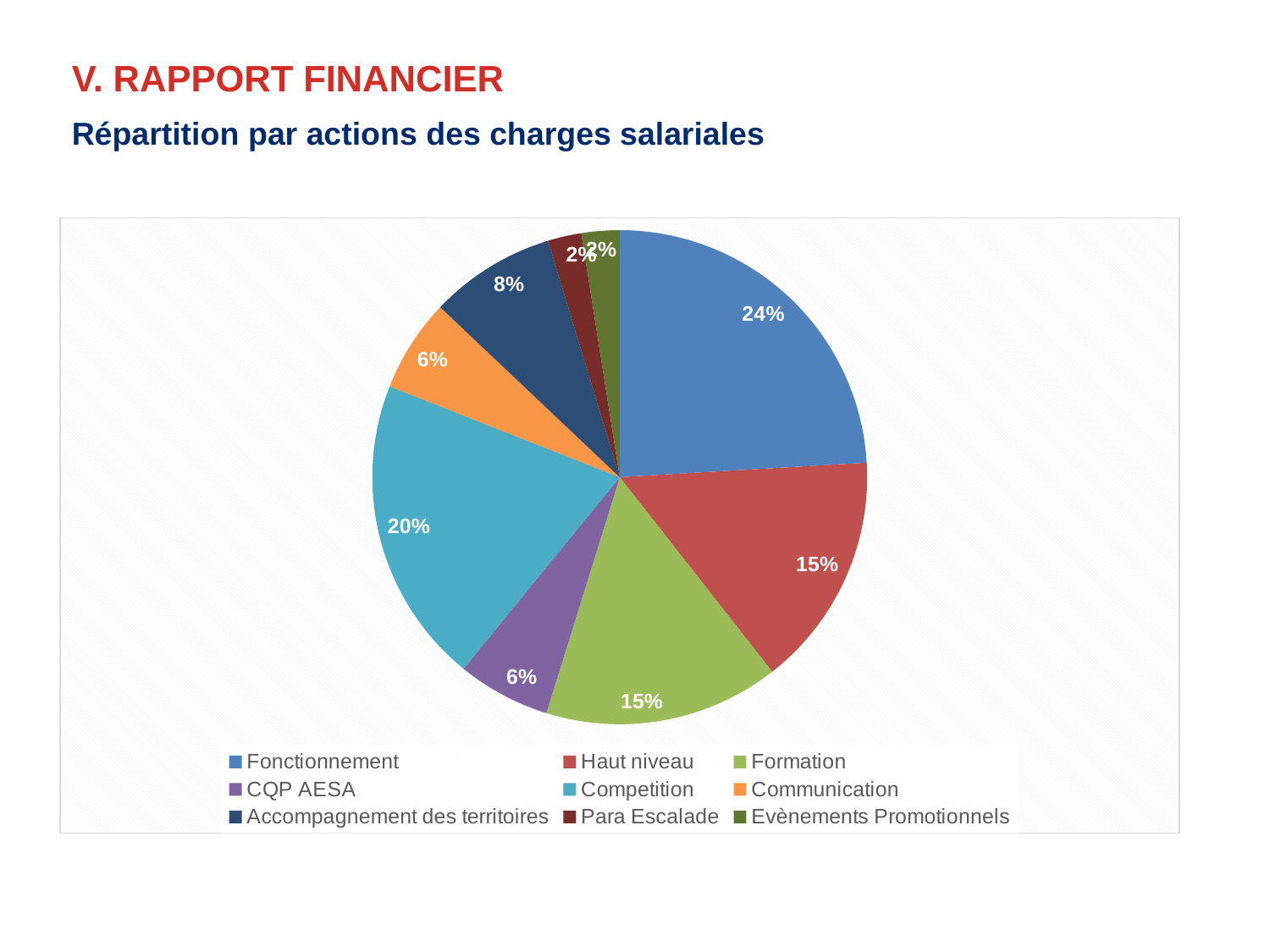
What is the value shown for Communication? 6% Which category is shown in orange in the legend? Communication What is the value shown for Accompagnement des territoires? 8% What is the subtitle describing the chart on the slide? Répartition par actions des charges salariales Which category has the largest share of the pie? Fonctionnement What share of the pie does Fonctionnement represent? 24% What is the value shown for Competition? 20% What is the difference in percentage points between Fonctionnement and Competition? 4 What is the value shown for Haut niveau? 15% What kind of chart is shown on the slide? pie chart How many categories does the legend list? 9 Which is larger, the share for Fonctionnement or the share for Competition? Fonctionnement